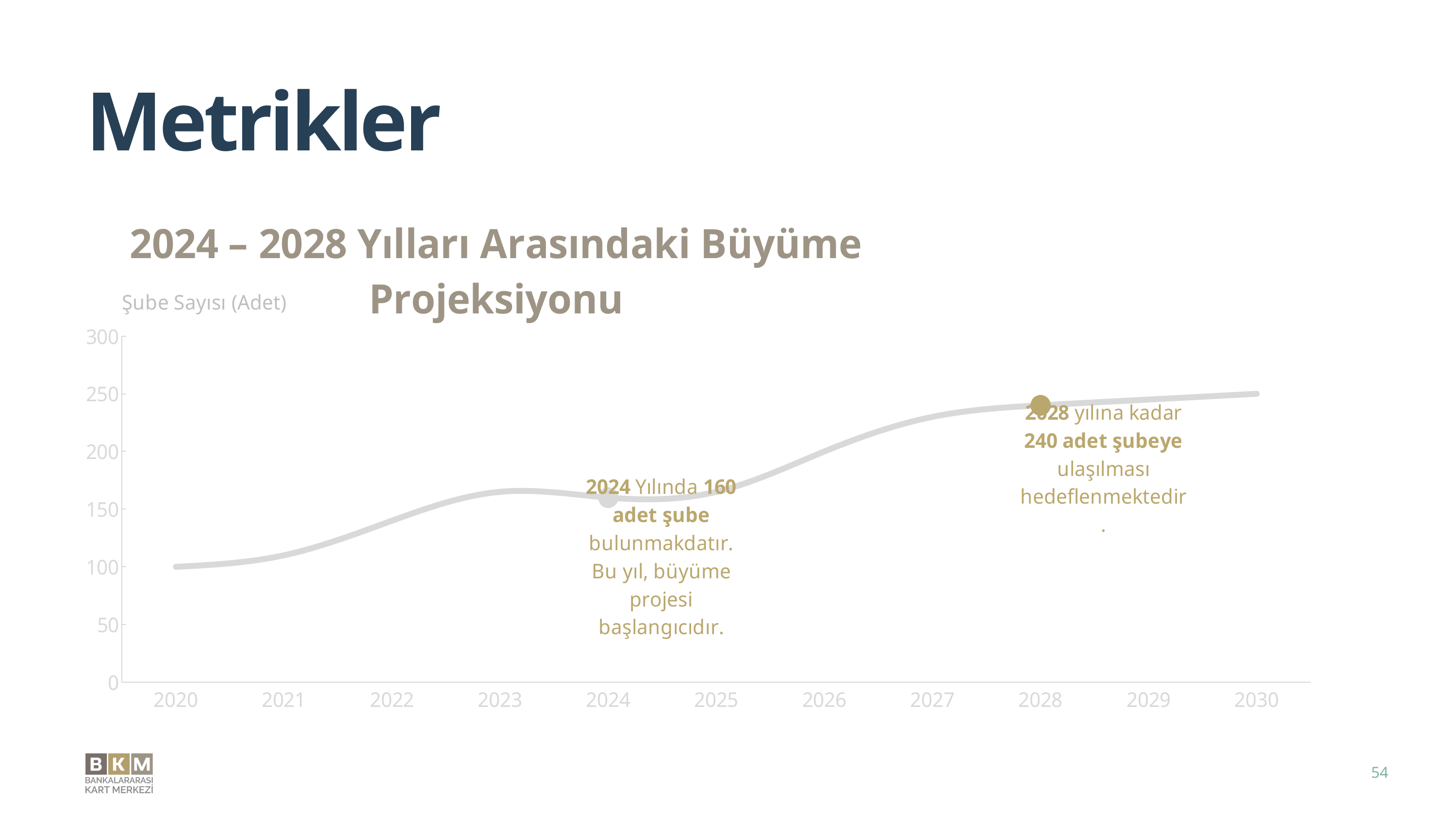
What is the difference between the 2028 target (240) and the 2024 value (160)? 80 What is the targeted number of branches for 2028 according to the annotation? 240 Do the values generally rise or fall from 2020 to 2030? rise Is the value for 2020 greater or less than 150? less What is the label of the y axis? Şube Sayısı (Adet) What is the number of branches (Şube Sayısı) in 2024 according to the annotation? 160 What is the title of the chart? 2024 – 2028 Yılları Arasındaki Büyüme Projeksiyonu What kind of chart is shown on the slide? line chart How many years are shown on the x axis? 11 Is the value for 2027 greater or less than 200? greater Is the value for 2030 greater or less than 200? greater Which year has the larger value, 2024 or 2028? 2028